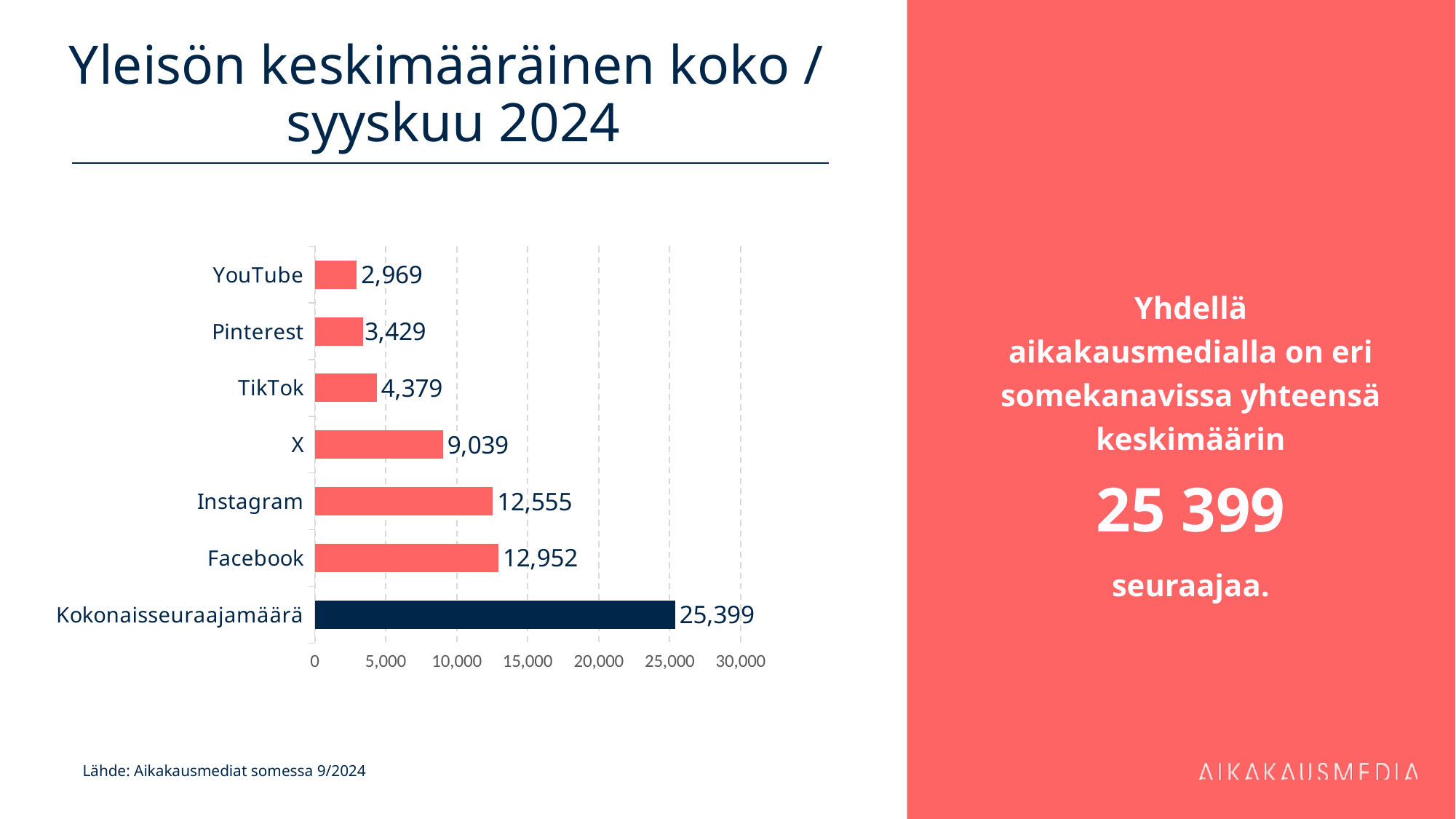
Which category has the lowest value? YouTube Which category has the highest value? Kokonaisseuraajamäärä How many categories are shown in the chart? 7 What kind of chart is shown on the slide? bar chart What is the value for Kokonaisseuraajamäärä? 25,399 Which bar is coloured dark navy instead of red? Kokonaisseuraajamäärä Which is larger, the value for Pinterest or the value for YouTube? Pinterest What is the difference between the values for X and TikTok? 4,660 What is the difference between the values for Facebook and Instagram? 397 Is the value for X greater or less than 10,000? less What is the value for Instagram? 12,555 What is the value for TikTok? 4,379